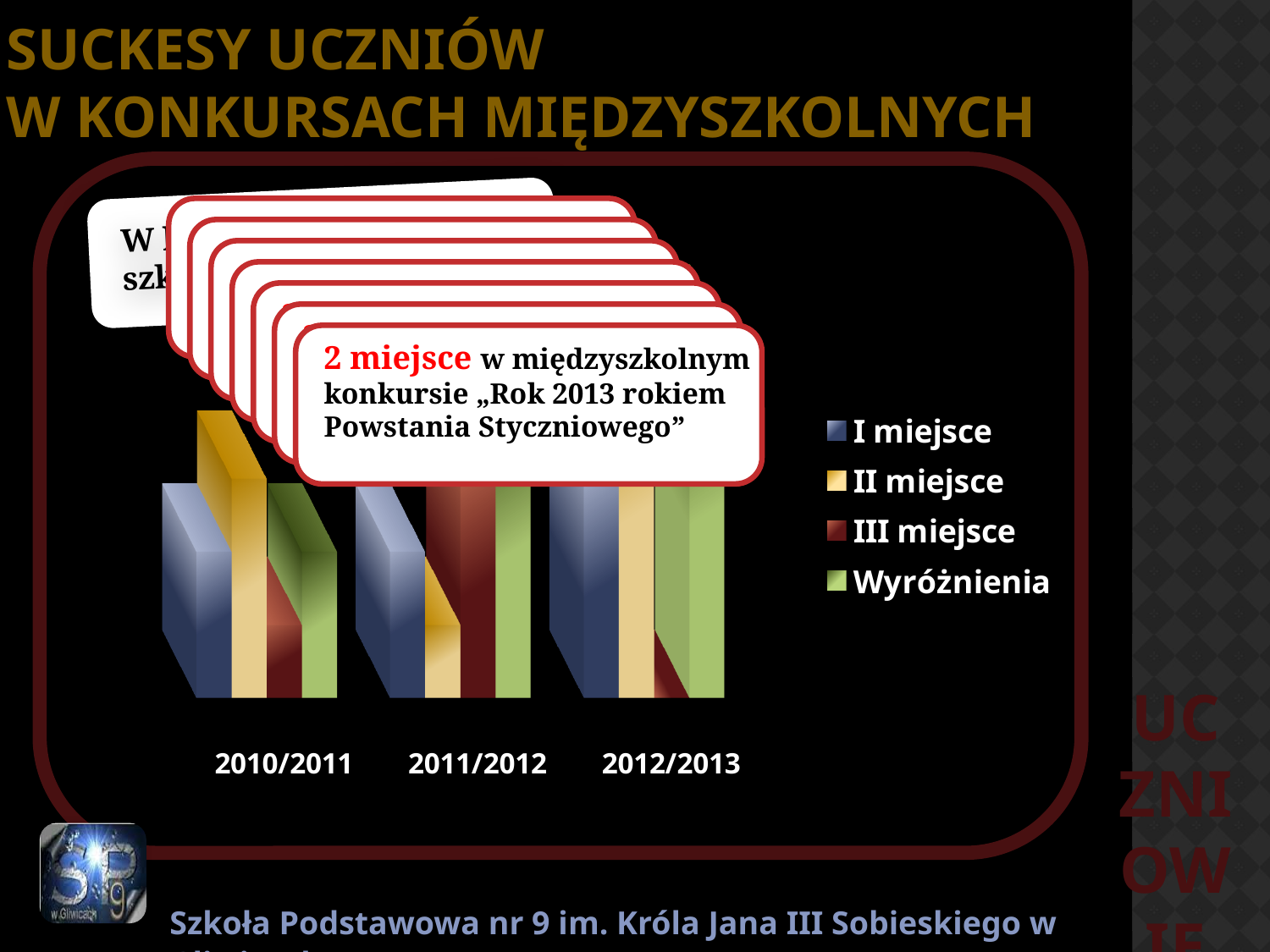
How many school-year categories are shown on the x axis of the chart? 3 In 2011/2012, which bar is taller: II miejsce or III miejsce? III miejsce In 2012/2013, which series has the lowest bar? III miejsce Which school years are shown as categories on the chart's x axis? 2010/2011, 2011/2012, 2012/2013 How many series does the chart legend list? 4 What kind of chart is shown on the slide? bar chart Which series in the chart legend is shown in green? Wyróżnienia In 2010/2011, which series has the highest bar? II miejsce In 2011/2012, which bar is taller: I miejsce or II miejsce? I miejsce In 2012/2013, which bar is taller: III miejsce or Wyróżnienia? Wyróżnienia